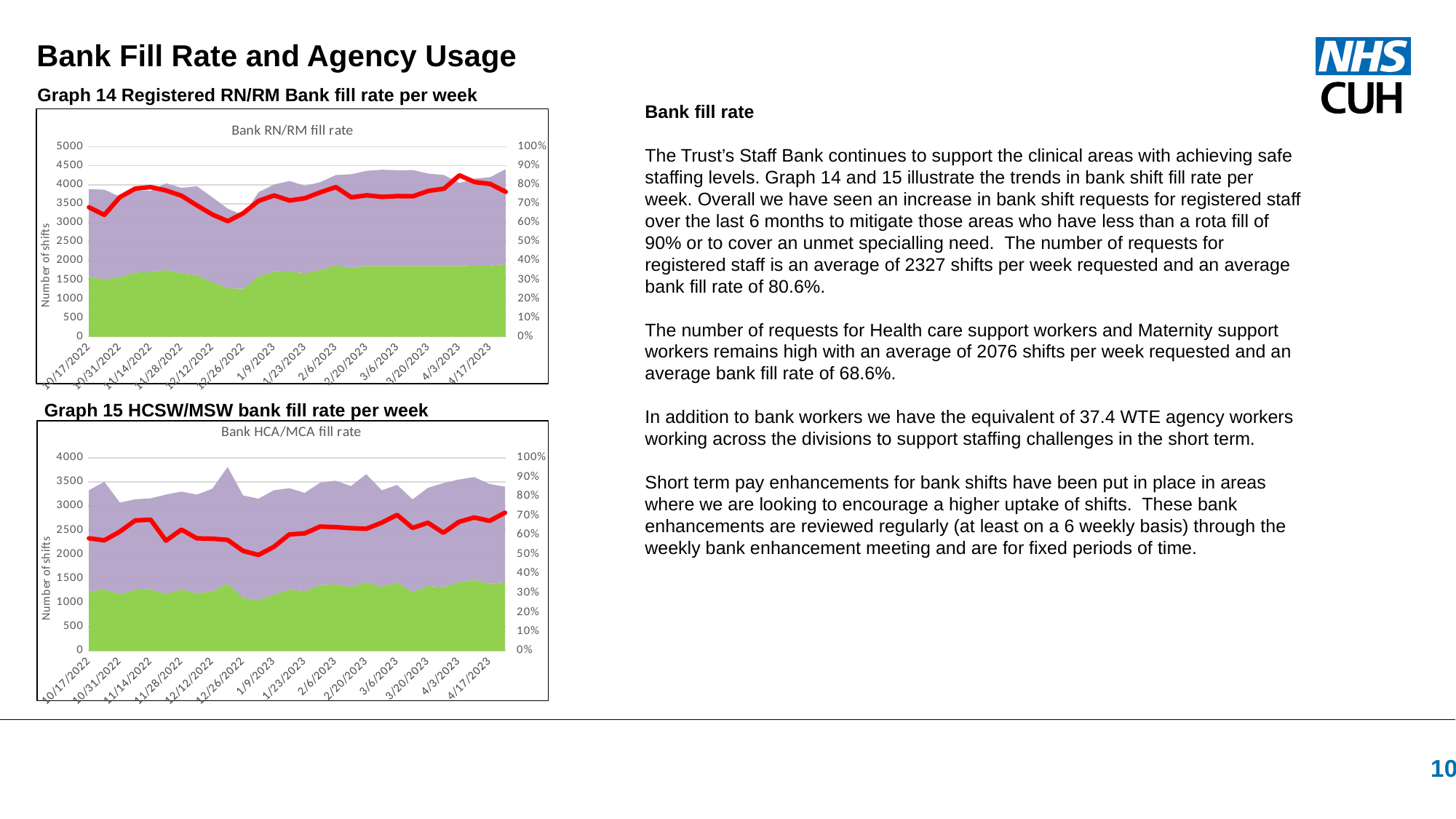
What is the label on the left vertical axis of the bottom chart (Graph 15)? Number of shifts In Graph 15 (Bank HCA/MCA fill rate), is the top of the green area at 4/3/2023 greater or less than 1500 shifts? less What is the title printed inside the top chart (Graph 14)? Bank RN/RM fill rate In Graph 14 (Bank RN/RM fill rate), does the red fill-rate line rise or fall between 12/26/2022 and 4/3/2023? rise In Graph 14 (Bank RN/RM fill rate), is the top of the green area at 12/26/2022 greater or less than 1500 shifts? less In Graph 14 (Bank RN/RM fill rate), is the red fill-rate line higher at 4/3/2023 or at 12/26/2022? 4/3/2023 In Graph 15 (Bank HCA/MCA fill rate), does the red fill-rate line rise or fall overall between 1/9/2023 and 4/17/2023? rise In Graph 14 (Bank RN/RM fill rate), is the top of the purple area at 4/17/2023 greater or less than 4000 shifts? greater What kind of chart is Graph 14 (Bank RN/RM fill rate)? Area chart with a line overlay